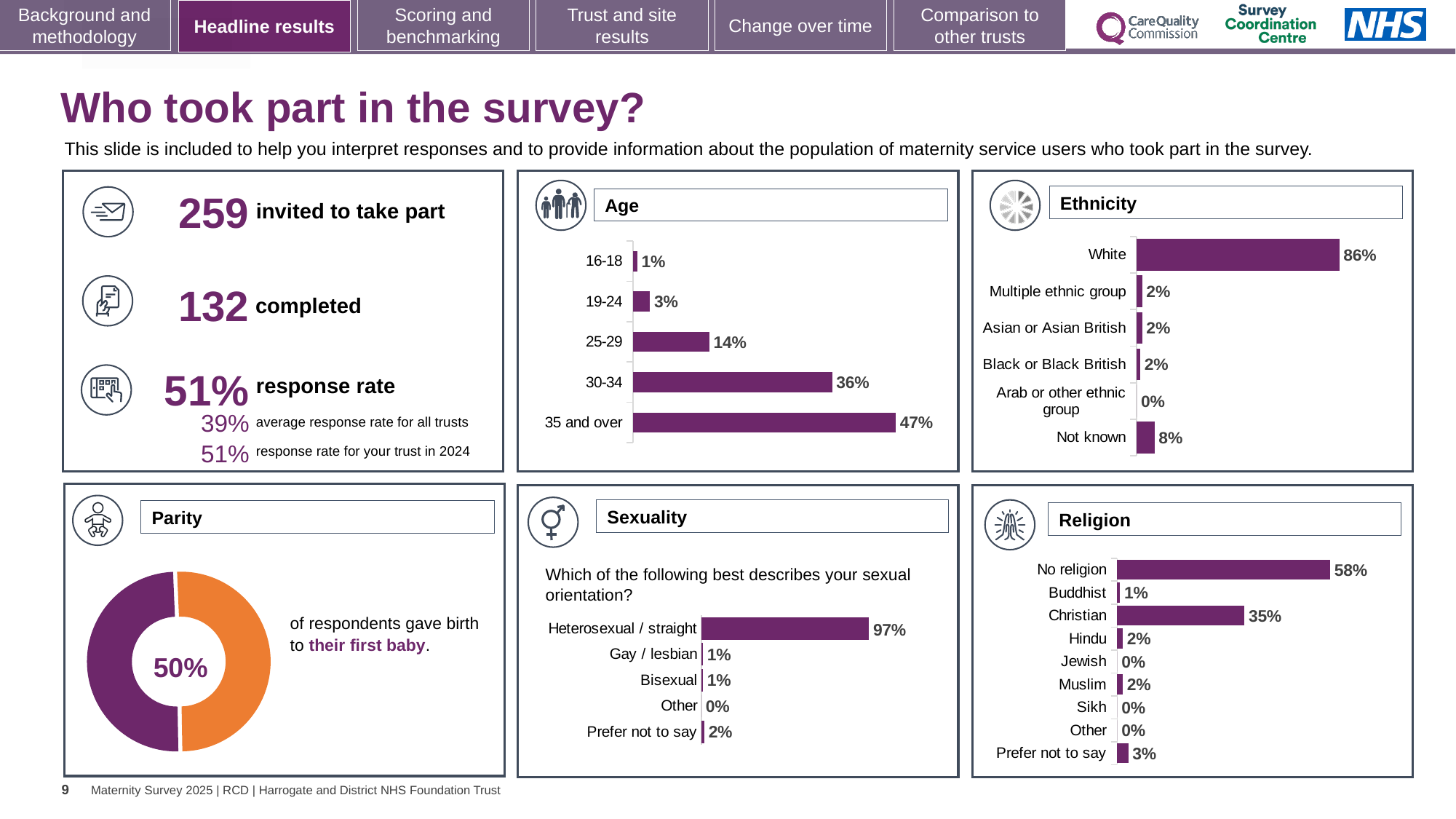
In the Religion chart, which is larger, No religion or Christian? No religion In the Age chart, what percentage of respondents were aged 35 and over? 47% What kind of chart is the Parity chart? Doughnut chart In the Age chart, which age group has the lowest percentage? 16-18 In the Religion chart, what is the difference between No religion and Christian? 23% In the Parity chart, what percentage of respondents gave birth to their first baby? 50% In the Sexuality chart, what percentage of respondents answered Heterosexual / straight? 97% In the Ethnicity chart, which category has the highest percentage? White In the Ethnicity chart, what percentage of respondents were White? 86% In the Ethnicity chart, how many ethnicity categories are shown? 6 In the Age chart, what is the difference between the 30-34 and 25-29 percentages? 22% In the Religion chart, what percentage of respondents were Christian? 35%